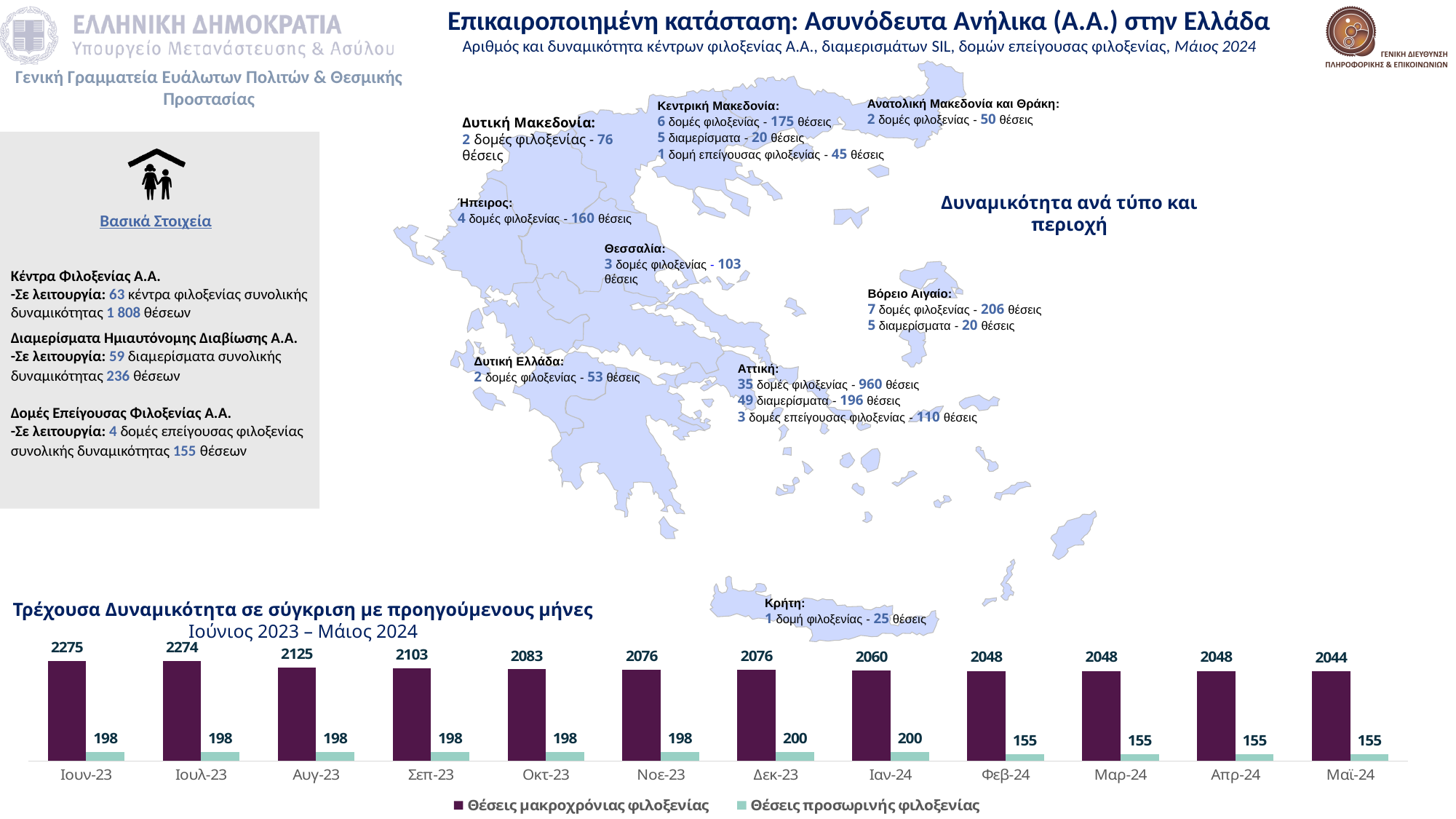
Do the values of Θέσεις μακροχρόνιας φιλοξενίας generally rise or fall from Ιουν-23 to Μαϊ-24? Fall What is the value of Θέσεις προσωρινής φιλοξενίας for Μαϊ-24? 155 What is the total of the two series for Δεκ-23? 2276 What is the value of Θέσεις μακροχρόνιας φιλοξενίας for Ιουν-23? 2275 How many series does the legend of the bar chart list? 2 Is Θέσεις προσωρινής φιλοξενίας larger in Ιαν-24 or in Φεβ-24? Ιαν-24 Which month has the lowest value of Θέσεις μακροχρόνιας φιλοξενίας? Μαϊ-24 Which month has the highest value of Θέσεις μακροχρόνιας φιλοξενίας? Ιουν-23 What type of chart is shown at the bottom of the slide? Bar chart How many months are shown on the x axis of the bar chart? 12 What is the difference between Θέσεις μακροχρόνιας φιλοξενίας in Ιουν-23 and Μαϊ-24? 231 What is the value of Θέσεις μακροχρόνιας φιλοξενίας for Αυγ-23? 2125